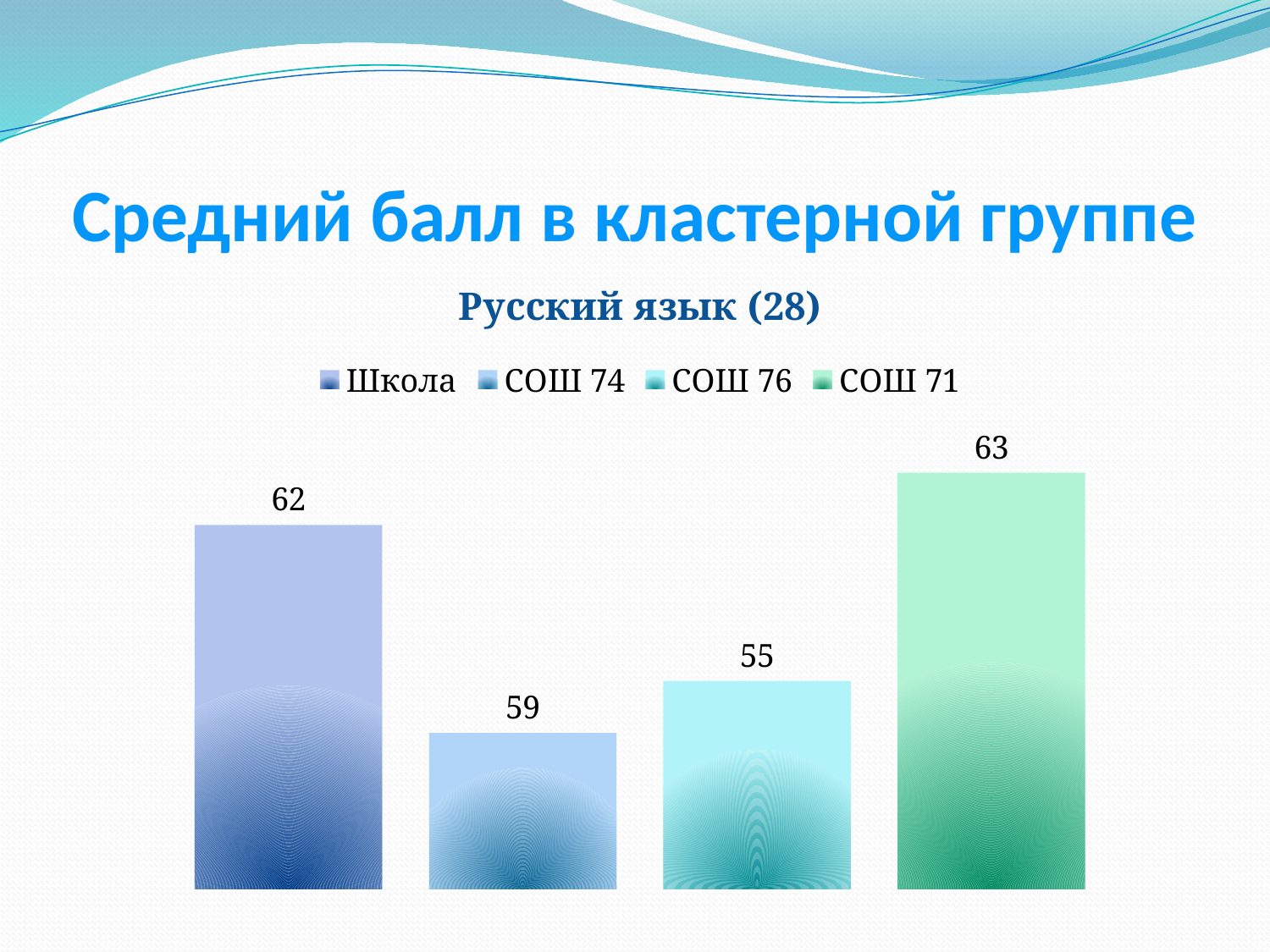
What is the value for СОШ 74? 59 What is the difference between the values for СОШ 71 and СОШ 76? 8 How many series does the legend list? 4 What is the difference between the values for Школа and СОШ 74? 3 Which series has the highest value? СОШ 71 What is the value for Школа? 62 Which is larger, the value for Школа or the value for СОШ 71? СОШ 71 Which series has the lowest value? СОШ 76 What kind of chart is shown on the slide? bar chart What is the title of the chart? Русский язык (28) What is the value for СОШ 76? 55 What is the value for СОШ 71? 63